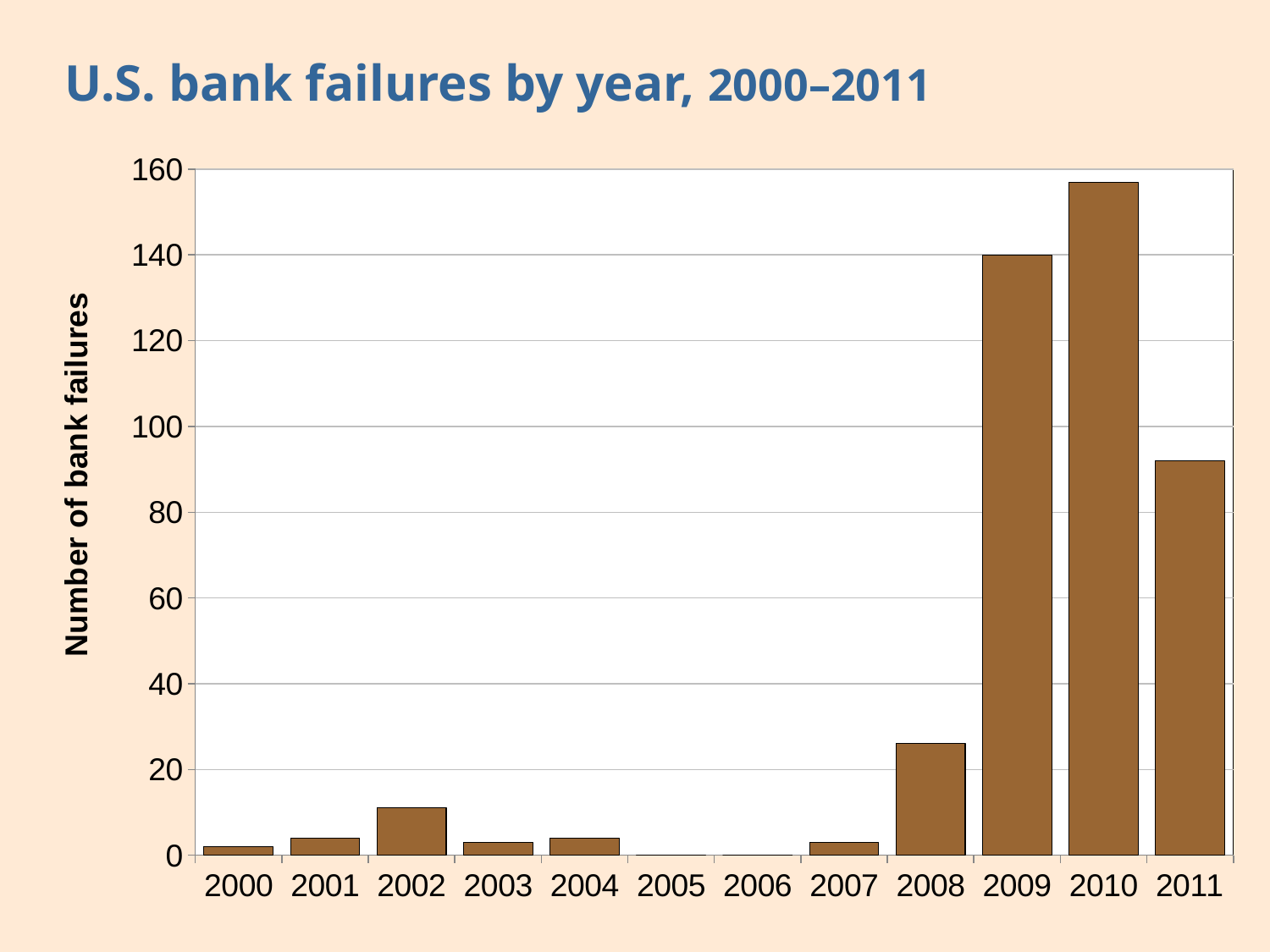
Is the value for 2002 greater or less than 20? less Is the value for 2010 greater or less than 140? greater Which year has the highest number of bank failures? 2010 How many years are shown on the x axis of the chart? 12 Is the value for 2011 greater or less than 100? less What kind of chart is shown on the slide? bar chart What is the number of bank failures for 2005? 0 What is the label on the y axis of the chart? Number of bank failures Do the values rise or fall from 2008 to 2010? rise Which year has more bank failures, 2009 or 2011? 2009 What is the number of bank failures for 2009? 140